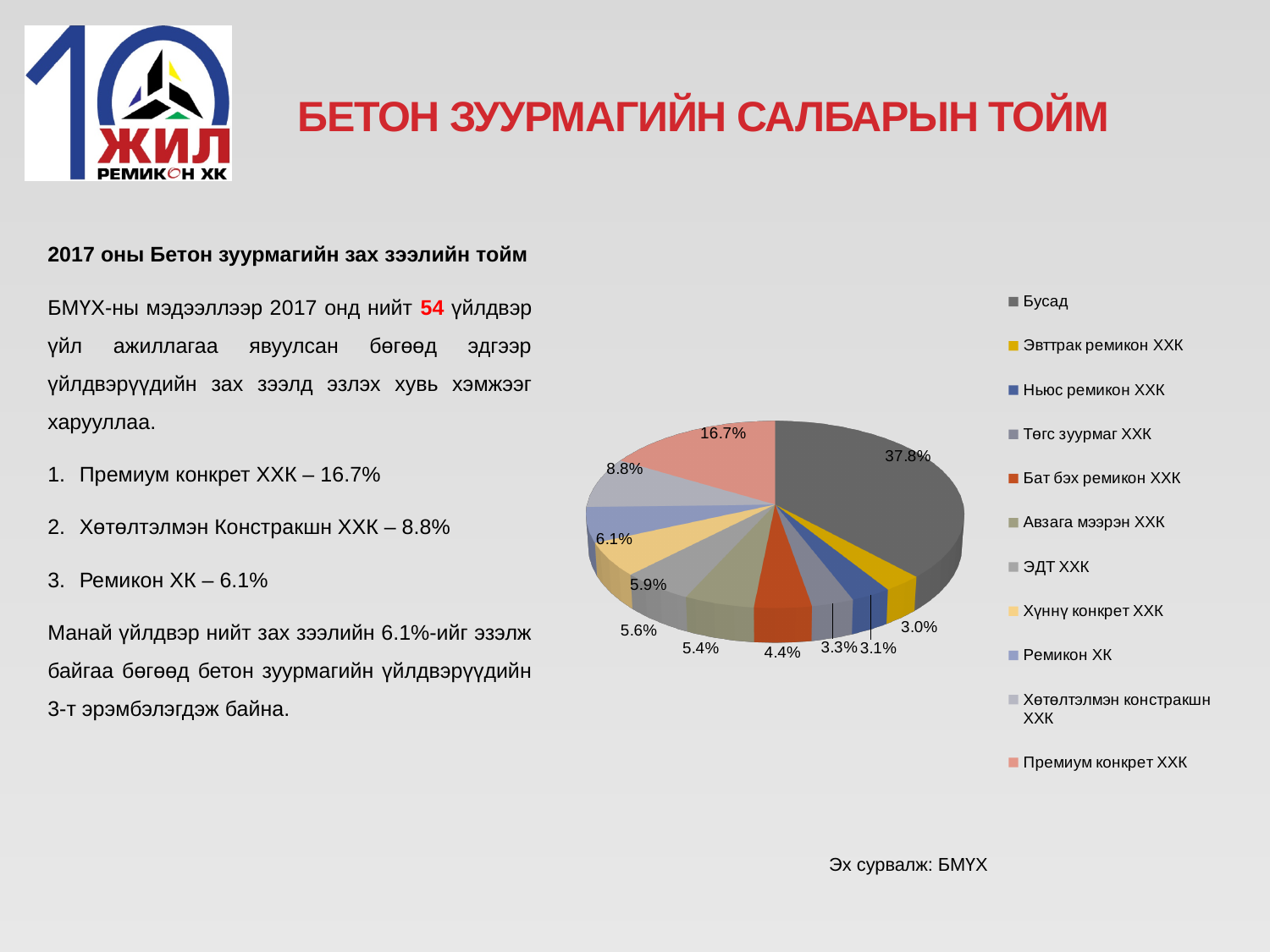
What is the difference between the shares of Премиум конкрет ХХК and Хөтөлтэлмэн конструкшн ХХК? 7.9% What is the difference between the shares of Бусад and Премиум конкрет ХХК? 21.1% Which has a larger share of the pie, Ремикон ХК or Хөтөлтэлмэн конструкшн ХХК? Хөтөлтэлмэн конструкшн ХХК What share of the pie does Бусад hold? 37.8% What is the title of the slide containing the pie chart? БЕТОН ЗУУРМАГИЙН САЛБАРЫН ТОЙМ Which category has the largest slice of the pie? Бусад What share of the pie does Хөтөлтэлмэн конструкшн ХХК hold? 8.8% What kind of chart is shown on the slide? Pie chart Which category has the smallest slice of the pie? Эвттрак ремикон ХХК What share of the pie does Премиум конкрет ХХК hold? 16.7% How many categories does the legend of the pie chart list? 11 What share of the pie does Ремикон ХК hold? 6.1%